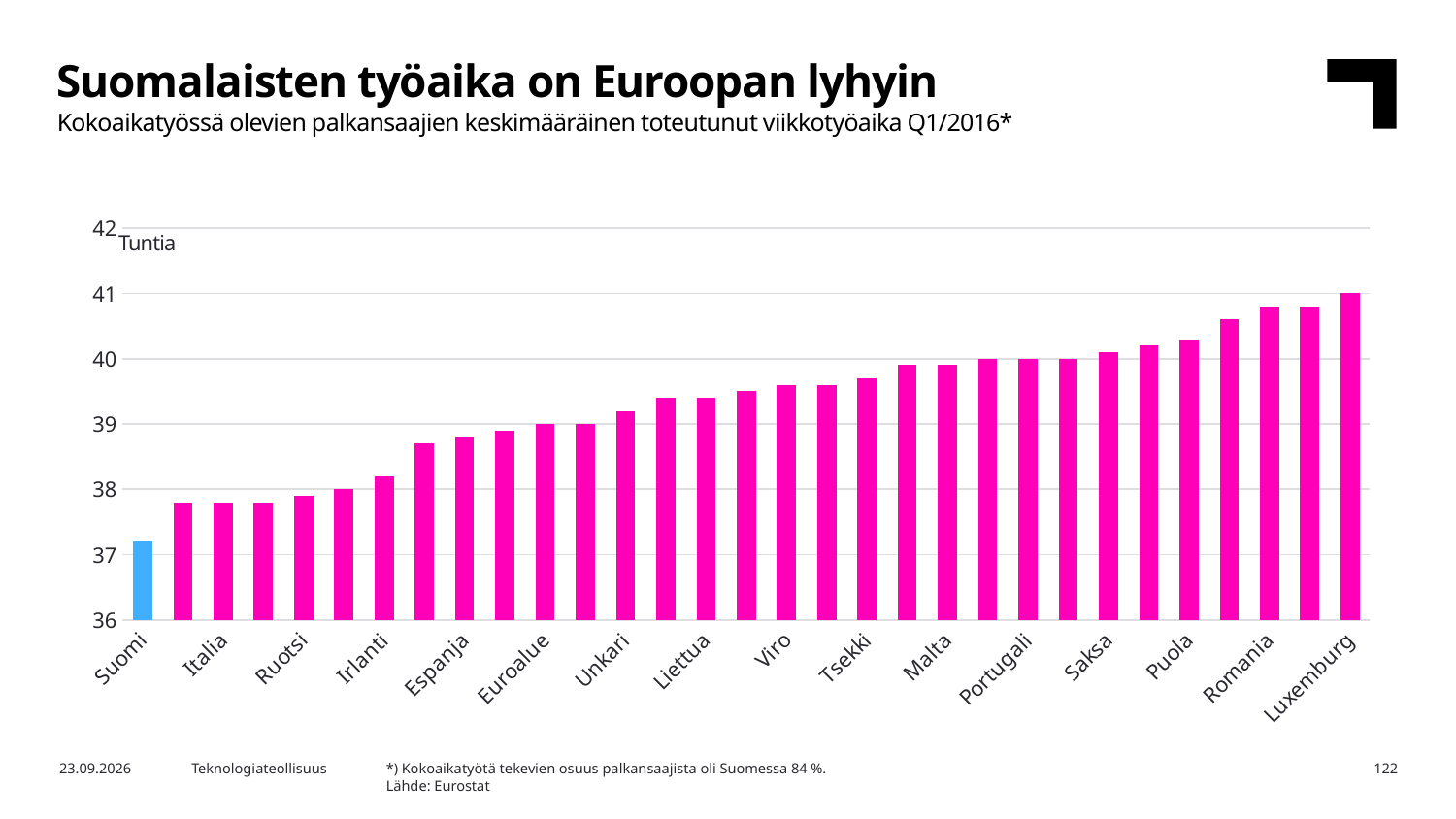
Is the value for Romania greater or less than 40? greater What unit label is shown at the top of the y axis? Tuntia Is the value for Luxemburg greater or less than 40? greater Which has a larger value, Italia or Puola? Puola Do the bar values rise or fall from left to right along the x axis? rise Is the value for Suomi greater or less than 38? less What kind of chart is shown on the slide? bar chart Which country has the lowest bar in the chart? Suomi Which has a larger value, Suomi or Luxemburg? Luxemburg Which country has the highest bar in the chart? Luxemburg